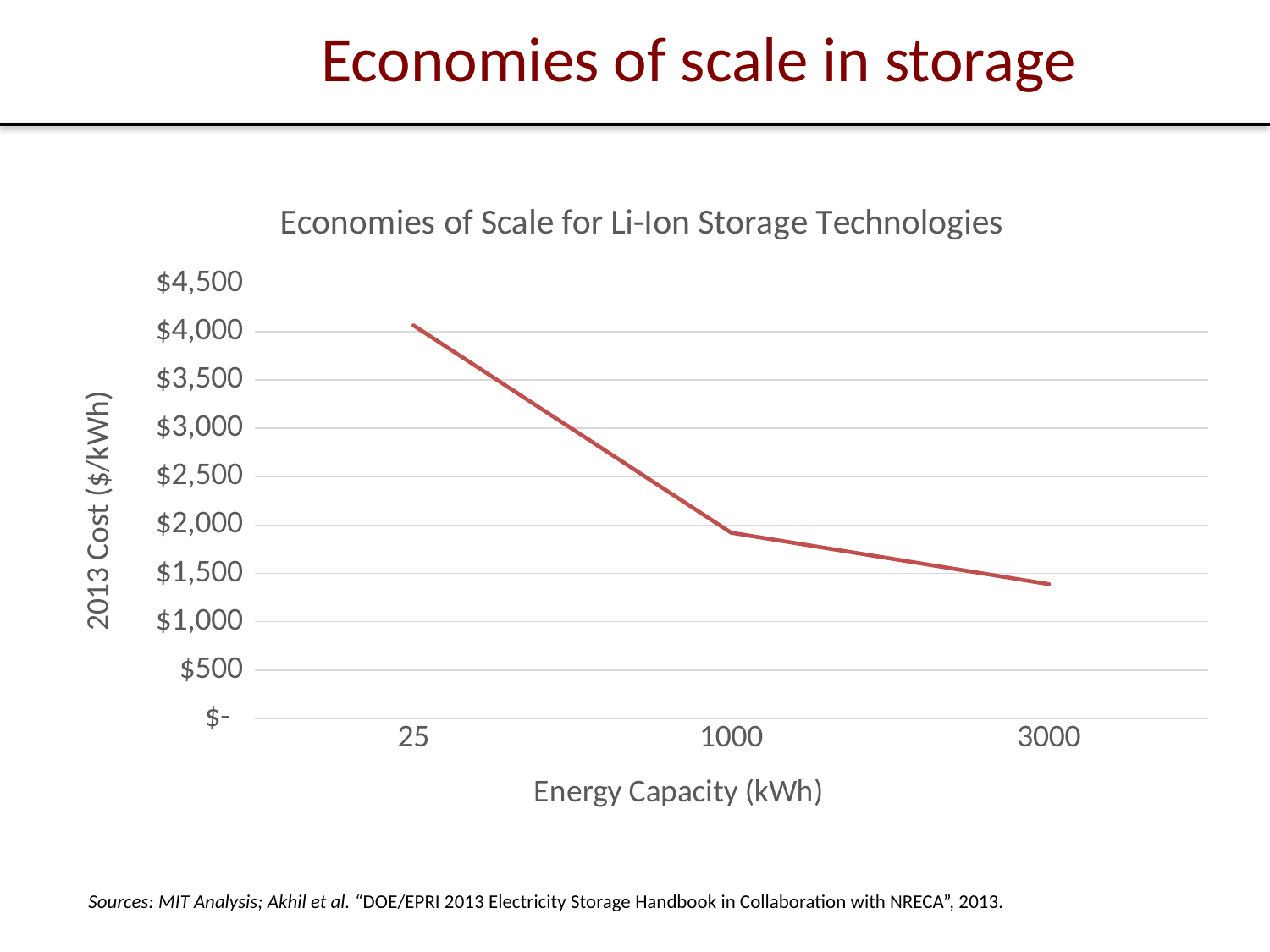
What is the label of the y axis? 2013 Cost ($/kWh) Is the 2013 cost for an energy capacity of 3000 kWh greater or less than $1,500? less Is the 2013 cost for an energy capacity of 25 kWh greater or less than $4,000? greater Is the 2013 cost for an energy capacity of 3000 kWh greater or less than $1,000? greater Which energy capacity has the lowest 2013 cost? 3000 Does the 2013 cost rise or fall as energy capacity increases along the x axis? fall Which has a higher 2013 cost: an energy capacity of 1000 kWh or 3000 kWh? 1000 What kind of chart is shown on the slide? line chart What is the title of the chart? Economies of Scale for Li-Ion Storage Technologies How many energy capacity points are plotted on the chart? 3 Which energy capacity has the highest 2013 cost? 25